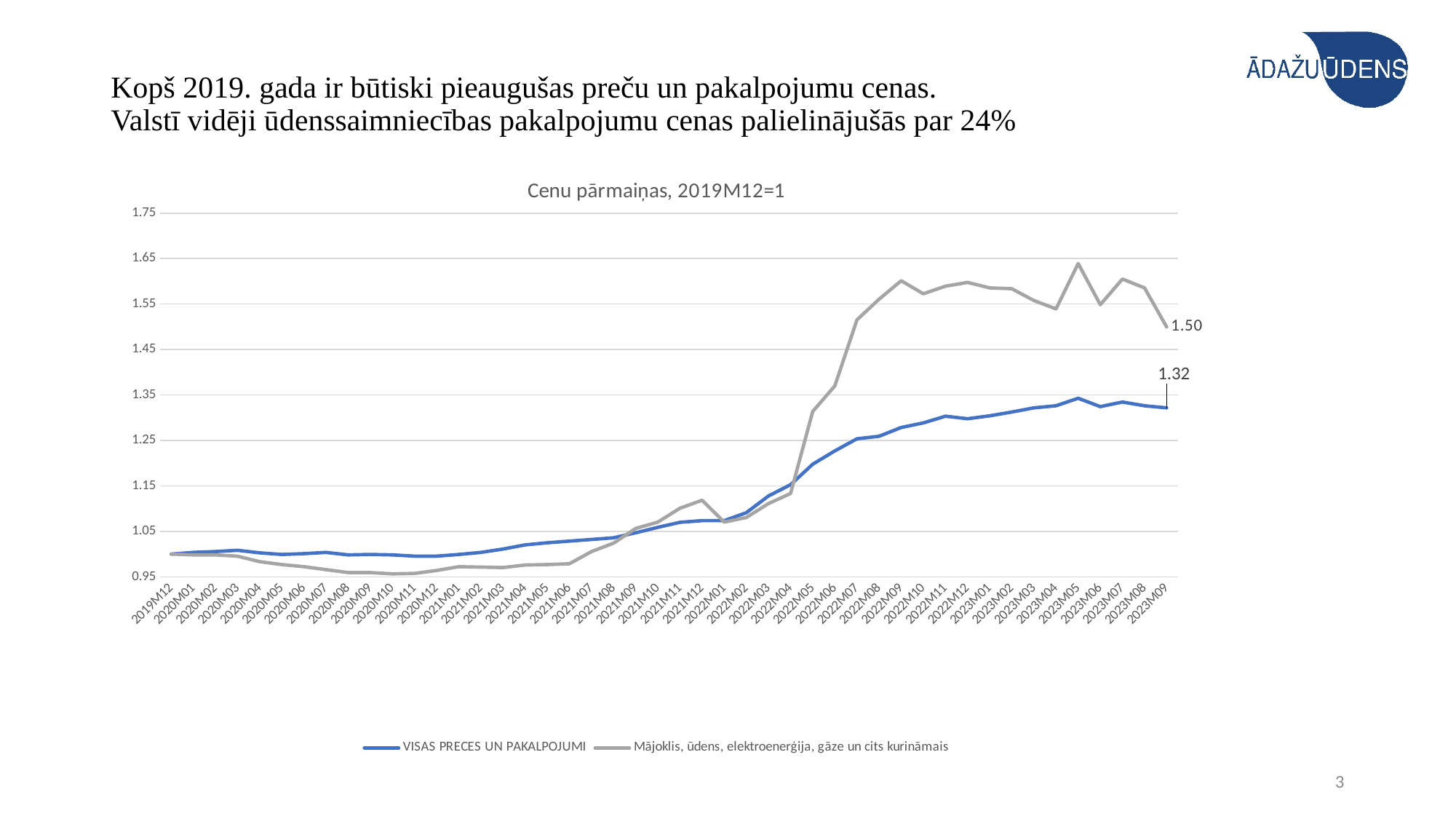
How many series does the legend list? 2 What is the value of VISAS PRECES UN PAKALPOJUMI at 2023M09? 1.32 Is the value for VISAS PRECES UN PAKALPOJUMI at 2022M01 greater or less than 1.15? less What is the difference between the two series' values at 2023M09? 0.18 At 2023M09, which series has the higher value? Mājoklis, ūdens, elektroenerģija, gāze un cits kurināmais What is the value of Mājoklis, ūdens, elektroenerģija, gāze un cits kurināmais at 2023M09? 1.50 How many months (points) are shown on the x axis? 46 Is the value for Mājoklis, ūdens, elektroenerģija, gāze un cits kurināmais at 2020M10 greater or less than 1.05? less What is the title of the chart? Cenu pārmaiņas, 2019M12=1 Is the value for Mājoklis, ūdens, elektroenerģija, gāze un cits kurināmais at 2023M05 greater or less than 1.55? greater What kind of chart is shown on the slide? line chart Does the VISAS PRECES UN PAKALPOJUMI line rise or fall overall from 2019M12 to 2023M09? rise